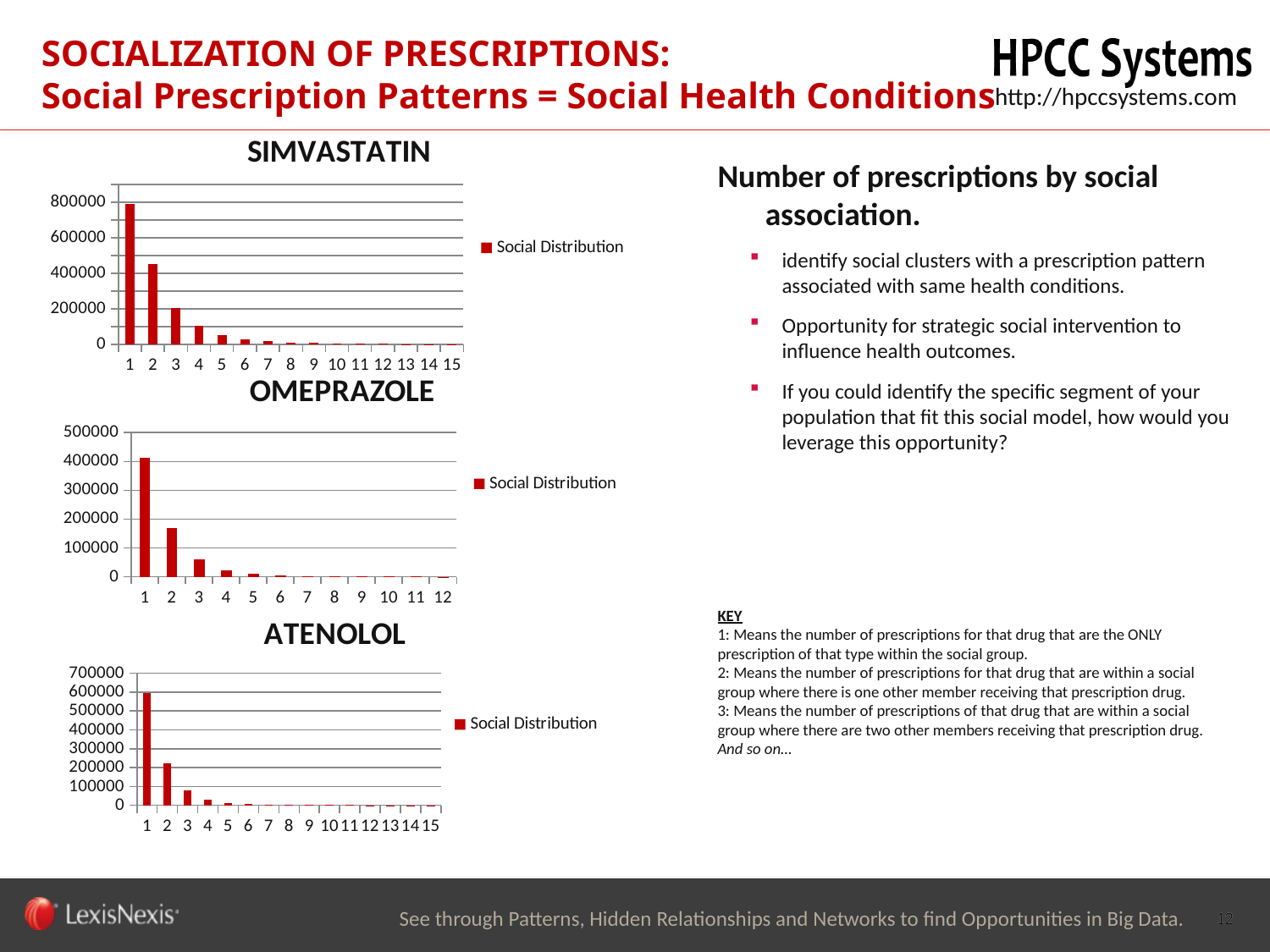
In the OMEPRAZOLE chart, is the value for category 2 greater or less than 200000? less How many series does the legend of the ATENOLOL chart list? 1 In the SIMVASTATIN chart, is the value for category 1 greater or less than 600000? greater In the OMEPRAZOLE chart, which category has the highest value? 1 In the OMEPRAZOLE chart, do the values rise or fall as you move from category 1 to category 12 along the x axis? fall How many categories are shown on the x axis of the OMEPRAZOLE chart? 12 In the SIMVASTATIN chart, which category has the highest value? 1 In the ATENOLOL chart, is the value for category 1 greater or less than 500000? greater What is the legend entry shown on the SIMVASTATIN chart? Social Distribution In the ATENOLOL chart, which is larger, the value for category 2 or the value for category 3? category 2 What kind of chart is the SIMVASTATIN chart? bar chart How many categories are shown on the x axis of the SIMVASTATIN chart? 15